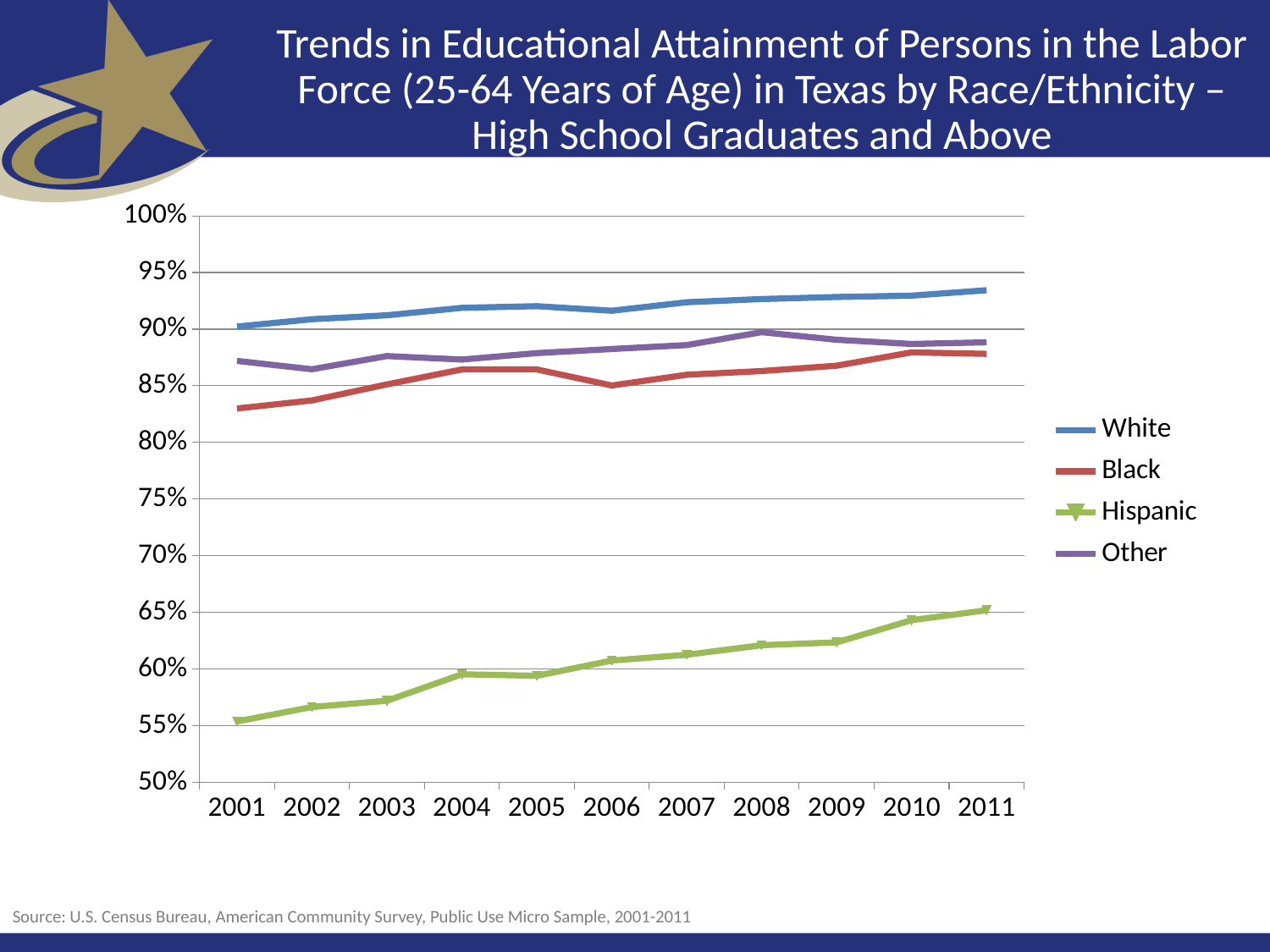
Is the value for Hispanic in 2001 greater or less than 60%? less What colour is the line for the Hispanic series? green How many years are shown along the x axis? 11 Is the value for Black in 2001 greater or less than 85%? less How many series does the legend list? 4 What kind of chart is shown on the slide? line chart Is the value for White in 2011 greater or less than 90%? greater In 2006, which is larger, the value for Black or the value for Other? Other Which series has the highest values across the chart? White Which series has the lowest values across the chart? Hispanic Does the Hispanic series generally rise or fall from 2001 to 2011? rise